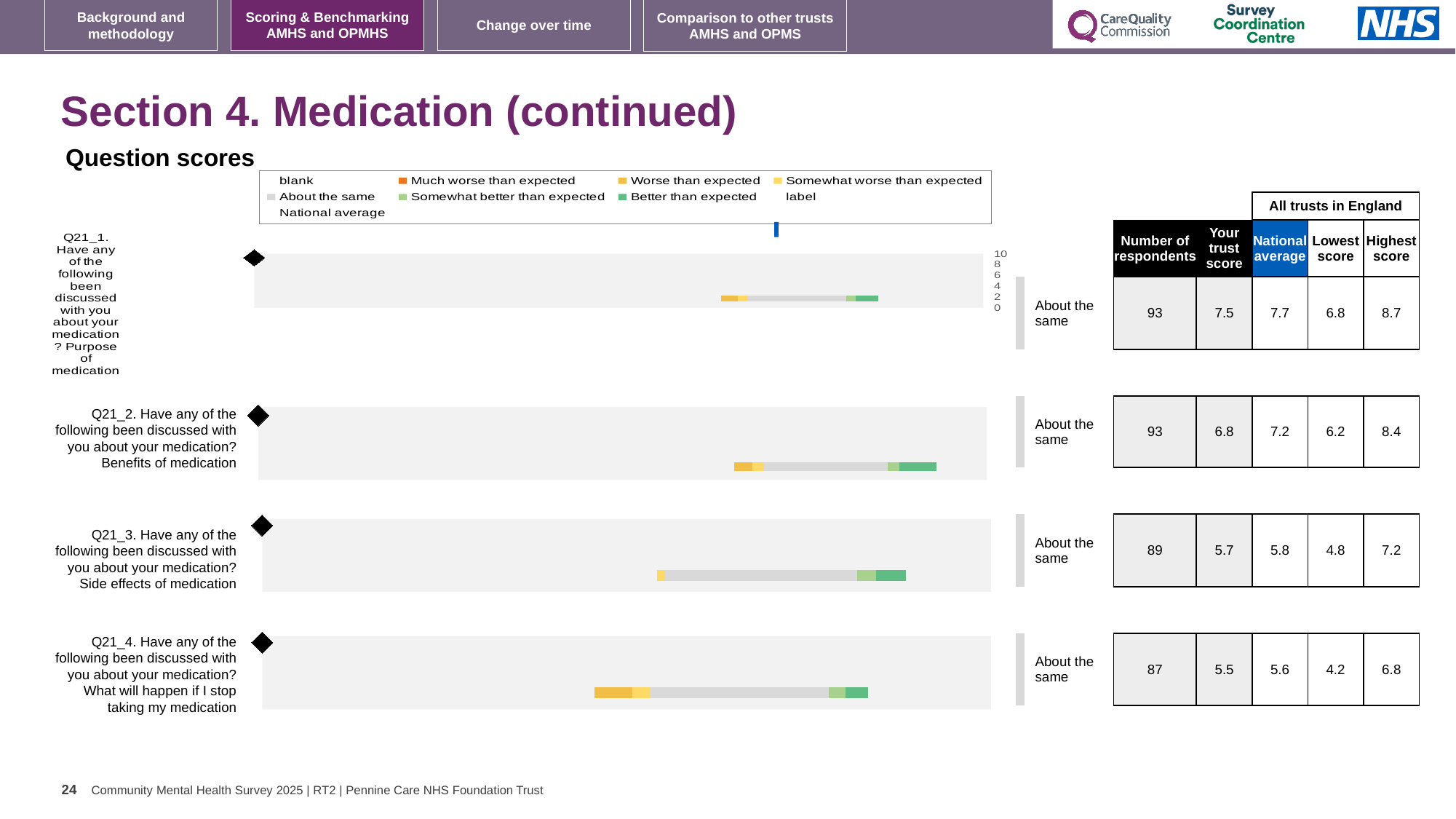
What is the national average for Q21_3 (Side effects of medication)? 5.8 For Q21_2 (Benefits of medication), what is the difference between the highest score and the lowest score across all trusts in England? 2.2 What is the number of respondents for Q21_4 (What will happen if I stop taking my medication)? 87 What kind of chart is used to show the question scores on this slide? bar chart What benchmark category is shown for Q21_2 (Benefits of medication)? About the same For Q21_1 (Purpose of medication), which is larger: the trust score or the national average? National average Which question has the highest 'Your trust score'? Q21_1 (Purpose of medication) Which question has the lowest 'Your trust score'? Q21_4 (What will happen if I stop taking my medication) How many questions (Q21_1 to Q21_4) are plotted on the slide? 4 What colour does the legend use for 'Better than expected'? Green What is the 'Your trust score' for Q21_1 (Purpose of medication)? 7.5 What is the highest score across all trusts in England for Q21_1 (Purpose of medication)? 8.7